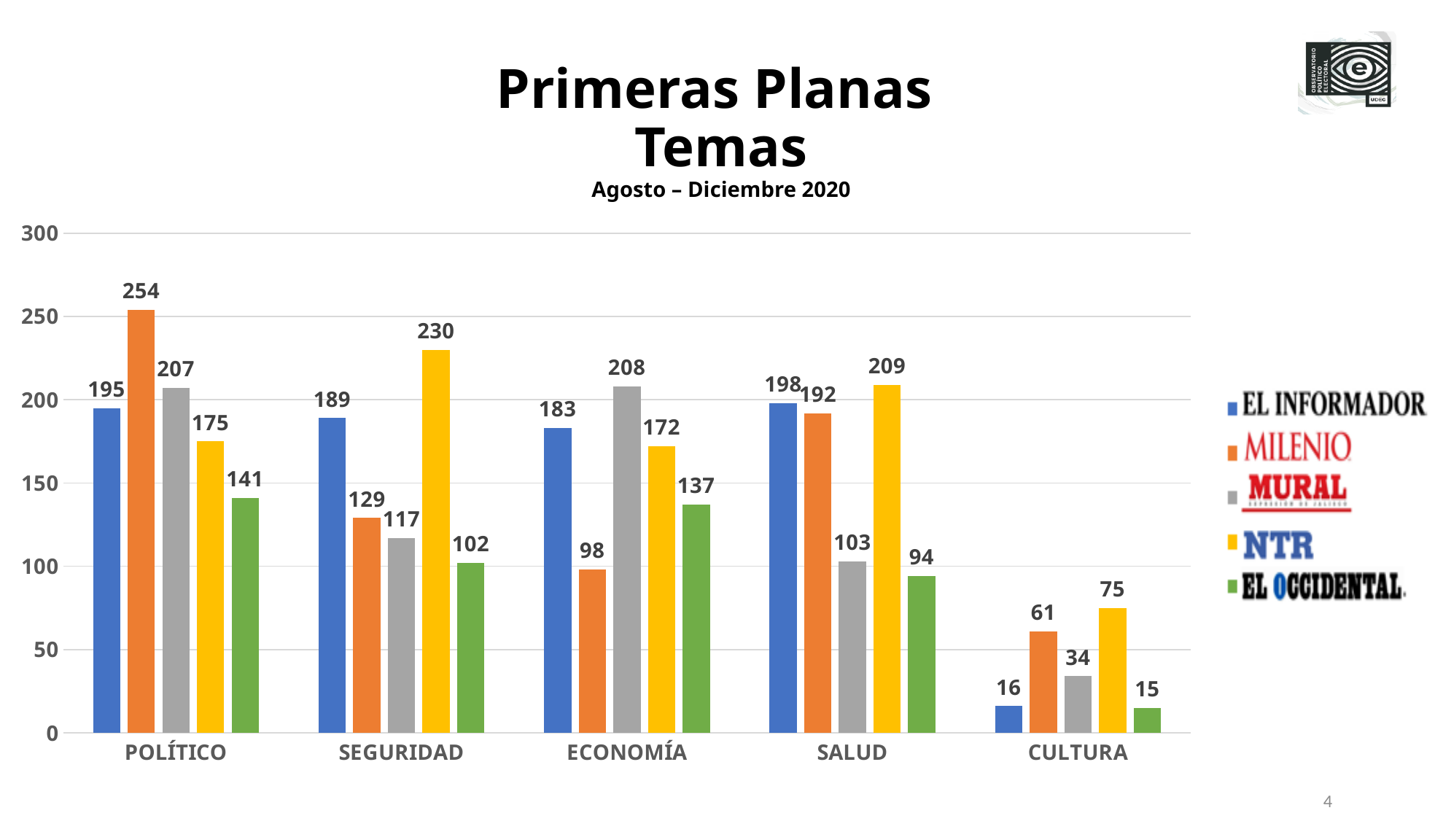
What is the difference between EL INFORMADOR and MILENIO in the SALUD category? 6 What is the value for MILENIO in the POLÍTICO category? 254 What is the value for MURAL in the ECONOMÍA category? 208 What is the value for EL OCCIDENTAL in the CULTURA category? 15 Which newspaper has the lowest value in the ECONOMÍA category? MILENIO How many newspapers does the legend list? 5 Which is larger in the SEGURIDAD category: MILENIO or MURAL? MILENIO What is the value for NTR in the SEGURIDAD category? 230 What period does the chart subtitle cover? Agosto – Diciembre 2020 How many topic categories are shown on the x axis? 5 What kind of chart is shown on the slide? Bar chart Which newspaper has the highest value in the SALUD category? NTR